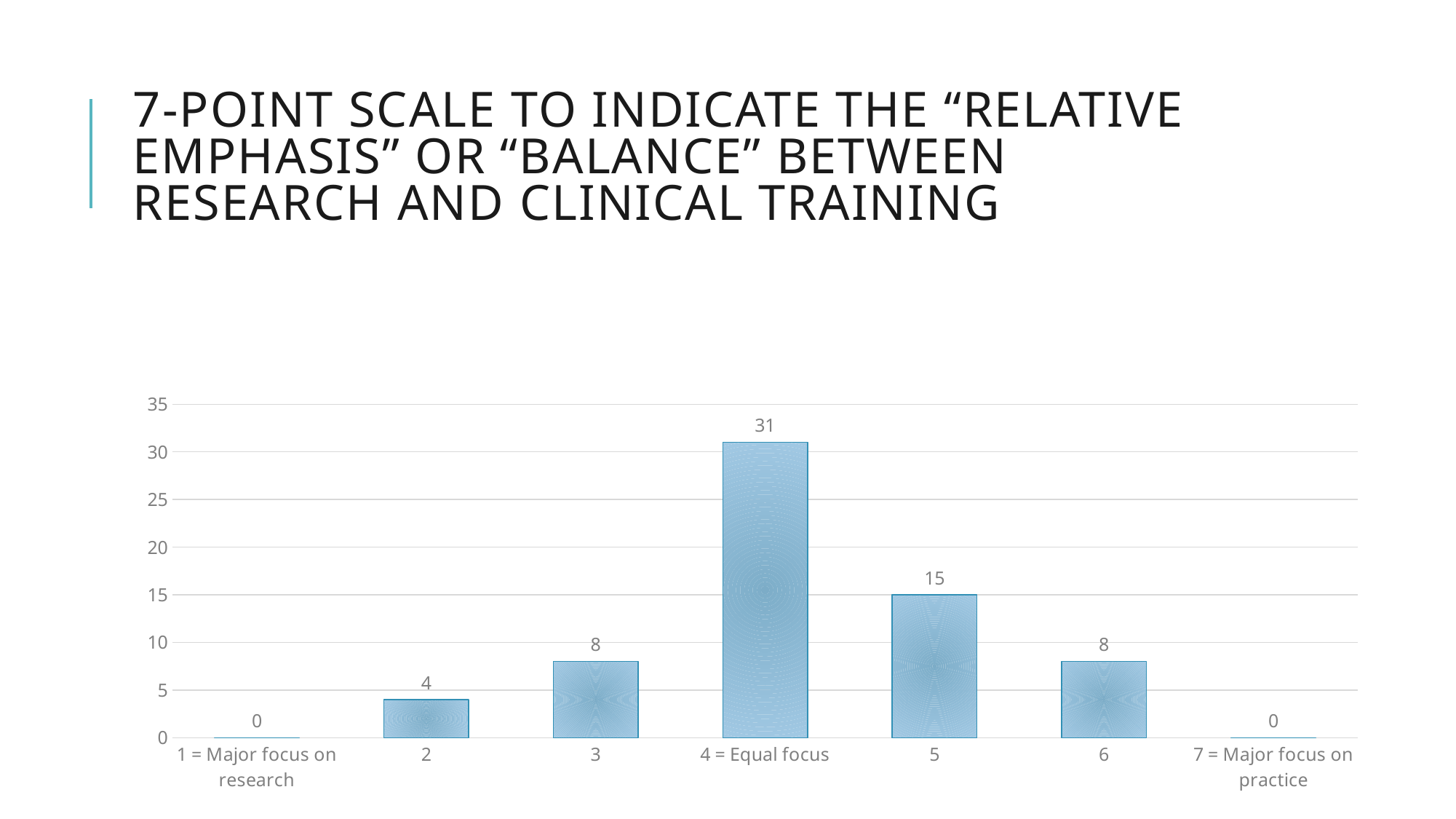
Which category has the highest value? 4 = Equal focus What is the value for category 5? 15 What kind of chart is shown on the slide? bar chart What is the difference between the values for category 3 and category 2? 4 How many categories are shown on the x axis? 7 What is the value for the category "4 = Equal focus"? 31 What is the value for "1 = Major focus on research"? 0 What is the difference between the values for "4 = Equal focus" and category 5? 16 What is the value for category 2? 4 Is the value for "4 = Equal focus" greater or less than 30? greater What is the label of the last category on the x axis? 7 = Major focus on practice Which is larger, the value for category 5 or the value for category 6? 5